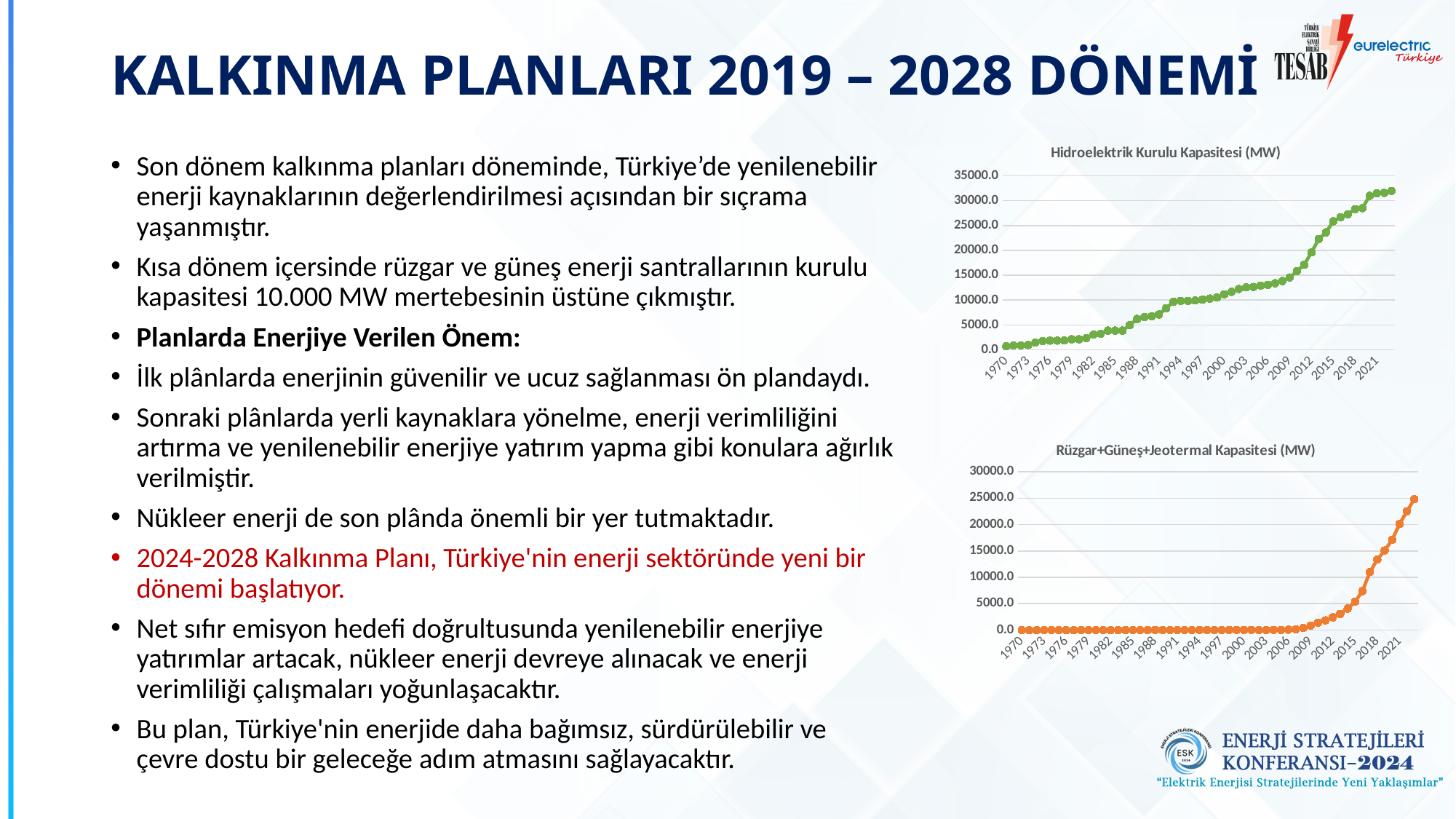
In the top chart 'Hidroelektrik Kurulu Kapasitesi (MW)', do the values rise or fall from 1970 to 2021? rise In the bottom chart 'Rüzgar+Güneş+Jeotermal Kapasitesi (MW)', is the value for 2018 greater or less than 10000.0? greater What is the title of the bottom chart on the slide? Rüzgar+Güneş+Jeotermal Kapasitesi (MW) In the bottom chart 'Rüzgar+Güneş+Jeotermal Kapasitesi (MW)', is the value for 2000 greater or less than 5000.0? less In the bottom chart 'Rüzgar+Güneş+Jeotermal Kapasitesi (MW)', do the values rise or fall from 2009 to 2021? rise What kind of chart is the top chart titled 'Hidroelektrik Kurulu Kapasitesi (MW)'? line chart In the top chart 'Hidroelektrik Kurulu Kapasitesi (MW)', is the value for 2018 greater or less than 25000.0? greater Which is larger in 2021: the value in the top chart 'Hidroelektrik Kurulu Kapasitesi (MW)' or the value in the bottom chart 'Rüzgar+Güneş+Jeotermal Kapasitesi (MW)'? Hidroelektrik Kurulu Kapasitesi (MW) What colour are the data points in the top chart 'Hidroelektrik Kurulu Kapasitesi (MW)'? green